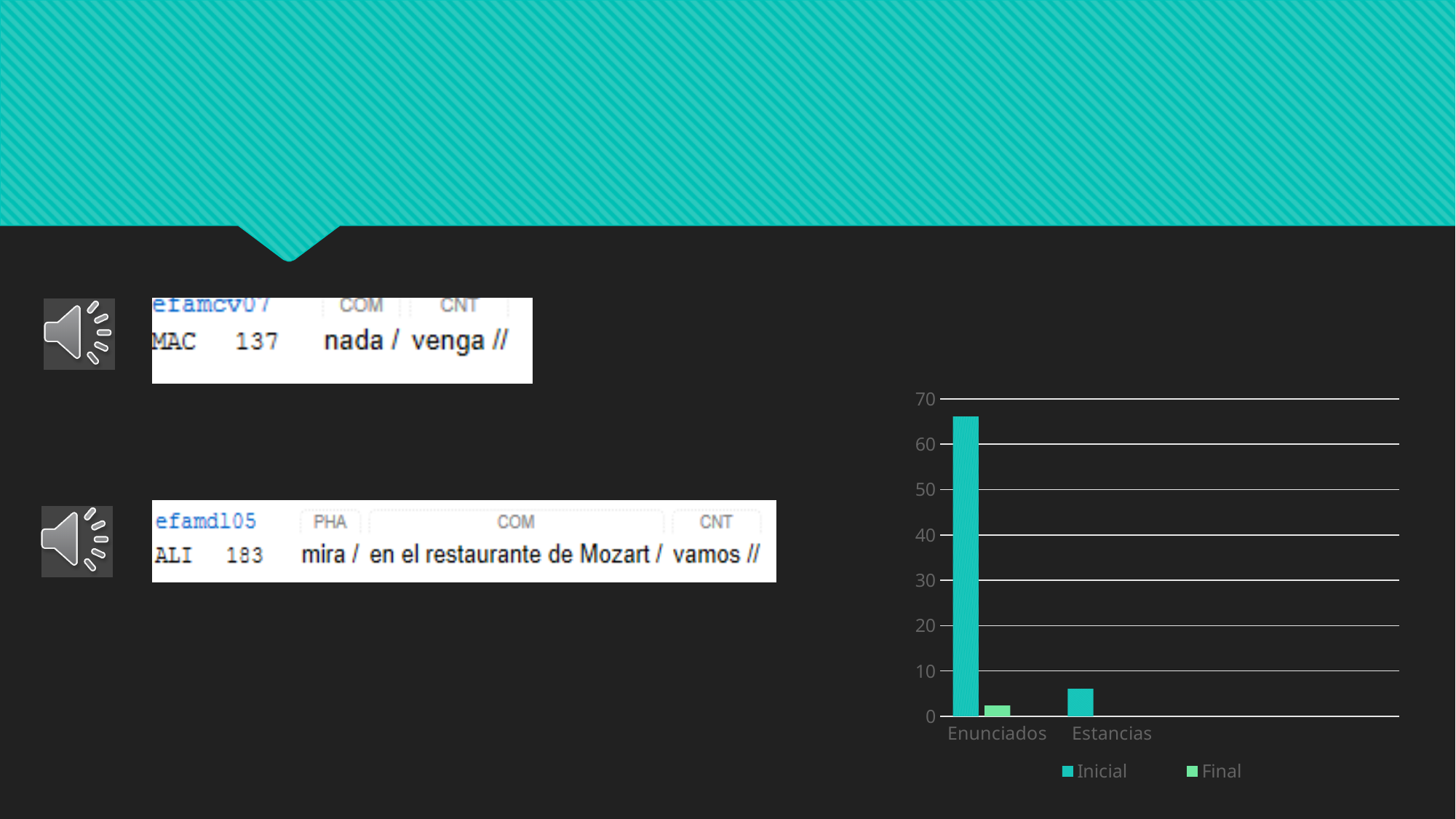
Is the Final value for Enunciados greater or less than 10? less Which is larger: the Inicial value for Enunciados or the Inicial value for Estancias? Enunciados Is the Inicial value for Estancias greater or less than 10? less Which category has the lowest Inicial value in the chart? Estancias How many categories are shown on the x axis of the chart? 2 How many series does the chart's legend list? 2 What are the two series named in the chart's legend? Inicial and Final Which category has the highest Inicial value in the chart? Enunciados What kind of chart is shown on the slide? bar chart Which is larger for Enunciados: the Inicial value or the Final value? Inicial What is the highest value shown on the chart's vertical axis? 70 Is the Inicial value for Enunciados greater or less than 60? greater